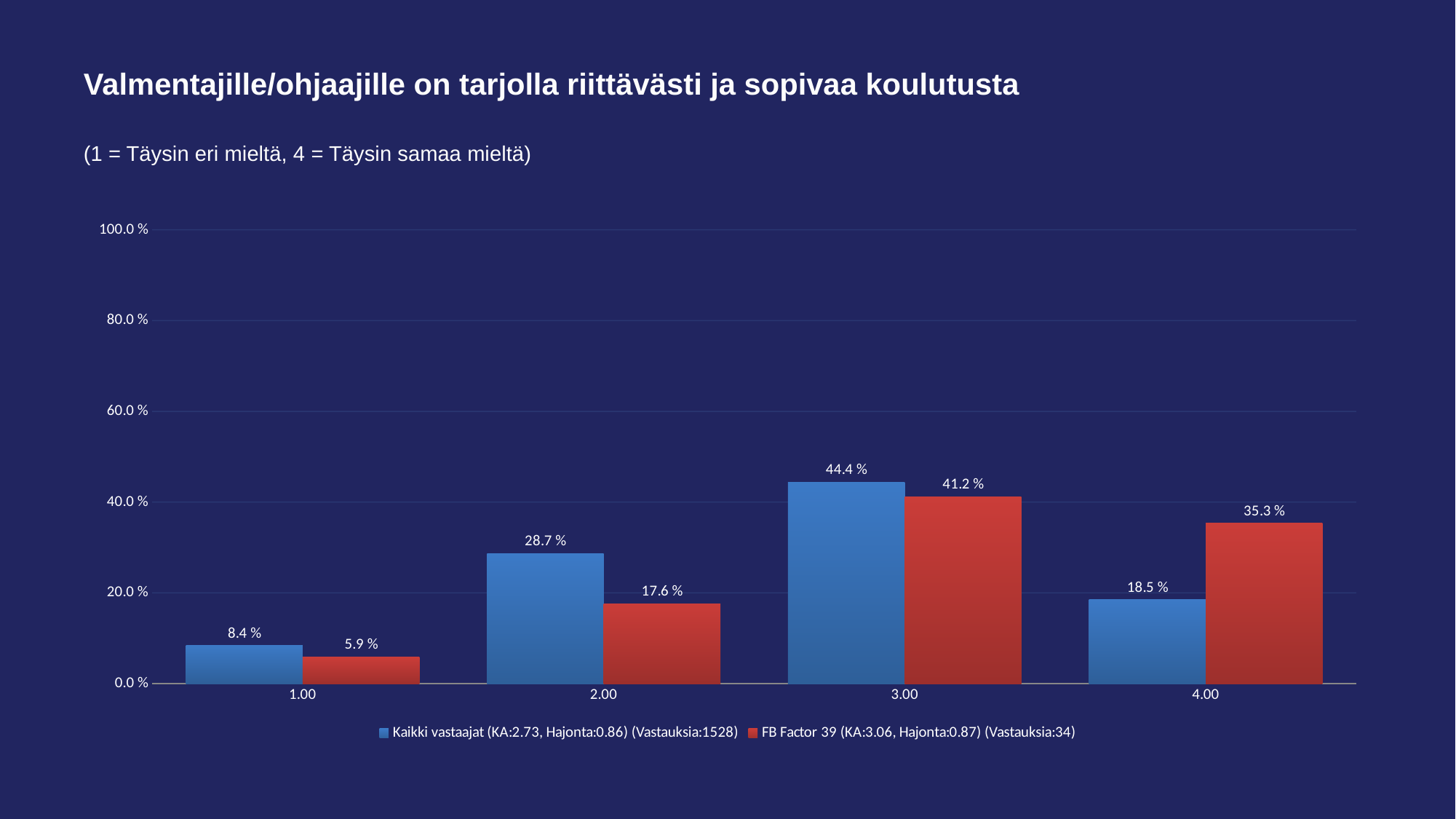
What is the title of the chart? Valmentajille/ohjaajille on tarjolla riittävästi ja sopivaa koulutusta Which category has the lowest value for FB Factor 39? 1.00 How many series does the legend list? 2 What is the value for Kaikki vastaajat at category 3.00? 44.4 % Is the value for FB Factor 39 at category 3.00 greater or less than 40.0 %? greater At category 4.00, which series has the larger value, Kaikki vastaajat or FB Factor 39? FB Factor 39 What kind of chart is shown on the slide? bar chart What is the difference between Kaikki vastaajat and FB Factor 39 at category 2.00? 11.1 % How many categories are shown on the x axis? 4 What is the value for FB Factor 39 at category 1.00? 5.9 % What is the value for FB Factor 39 at category 4.00? 35.3 % Which category has the highest value for Kaikki vastaajat? 3.00